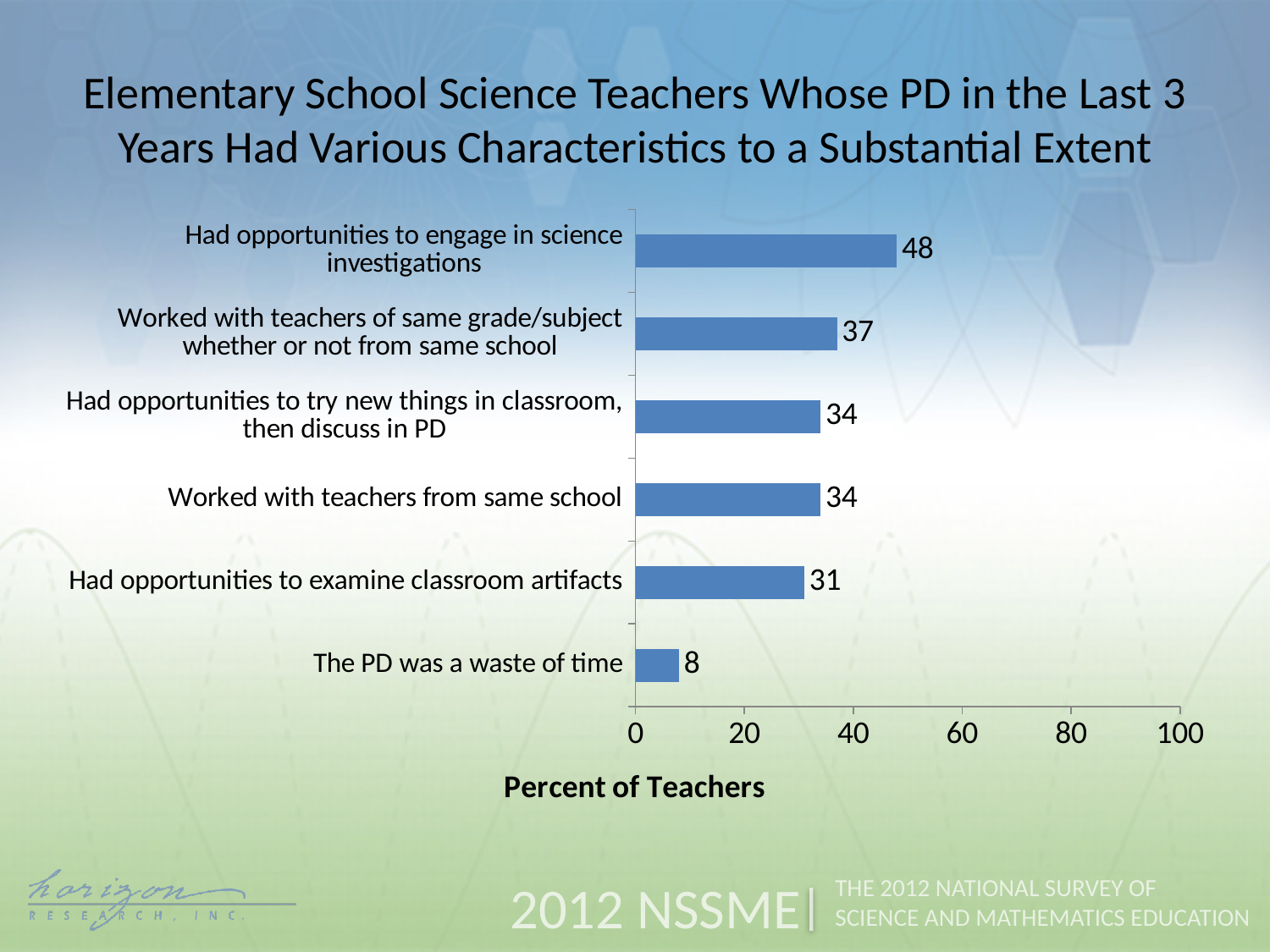
Which is larger: the value for 'Worked with teachers from same school' or 'Had opportunities to examine classroom artifacts'? Worked with teachers from same school What is the value for 'Had opportunities to examine classroom artifacts'? 31 What is the difference between the values for 'Had opportunities to engage in science investigations' and 'Worked with teachers of same grade/subject whether or not from same school'? 11 What is the label of the horizontal axis? Percent of Teachers Which category has the highest value? Had opportunities to engage in science investigations What is the value for 'The PD was a waste of time'? 8 What kind of chart is shown on the slide? Bar chart Which category has the lowest value? The PD was a waste of time What percent of teachers worked with teachers of same grade/subject whether or not from same school? 37 How many categories are shown in the chart? 6 Is the value for 'Had opportunities to engage in science investigations' greater or less than 40? greater What percent of teachers had opportunities to engage in science investigations? 48